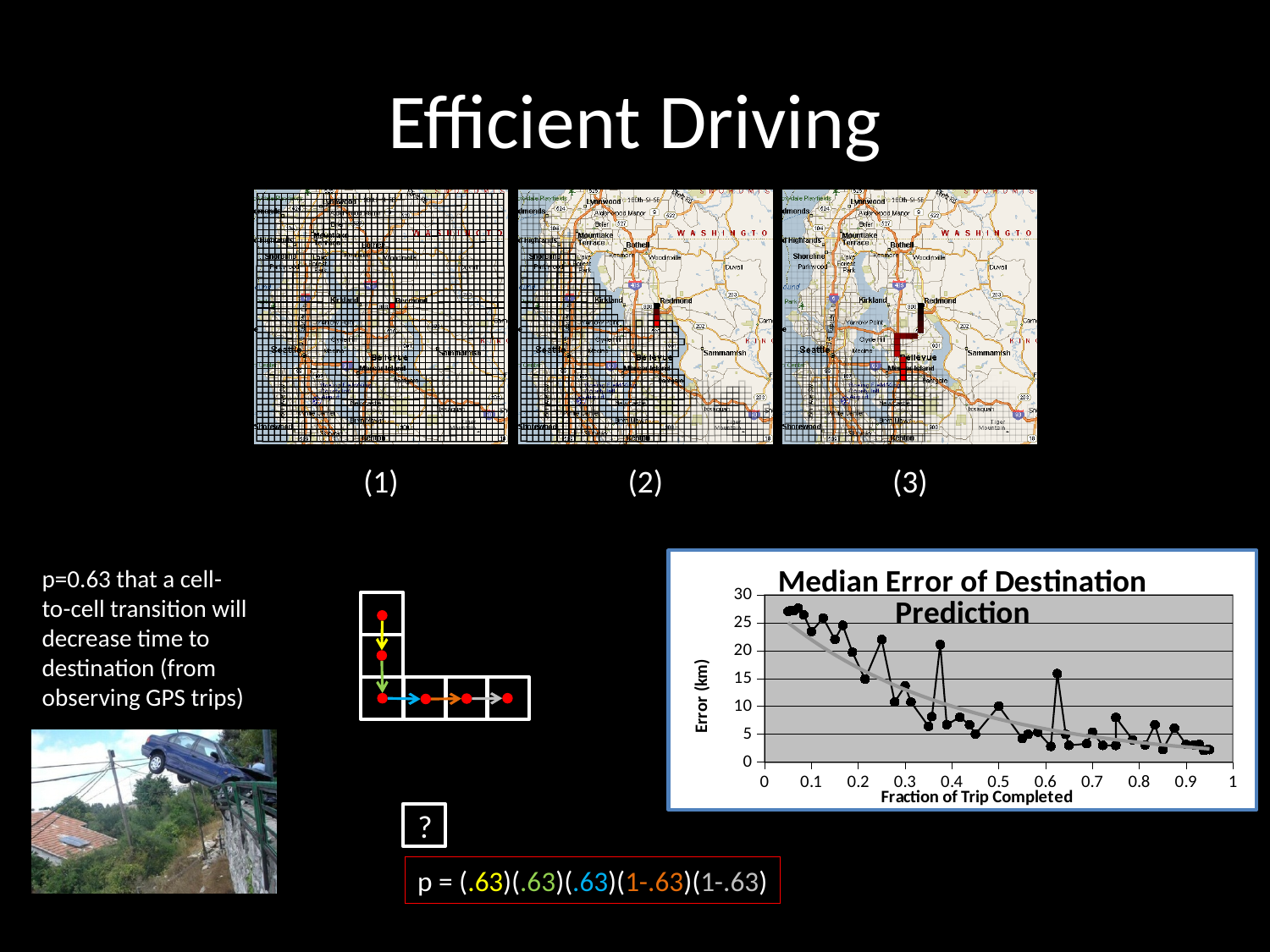
What is the maximum value shown on the y axis of the 'Median Error of Destination Prediction' chart? 30 On the 'Median Error of Destination Prediction' chart, is the error at a fraction of trip completed of about 0.9 greater or less than 10 km? less What is the title of the chart on the slide? Median Error of Destination Prediction On the 'Median Error of Destination Prediction' chart, is the error at a fraction of trip completed of about 0.1 greater or less than 20 km? greater What is the label of the y axis on the 'Median Error of Destination Prediction' chart? Error (km) On the 'Median Error of Destination Prediction' chart, is the error at a fraction of trip completed of about 0.95 greater or less than 5 km? less Do the values on the 'Median Error of Destination Prediction' chart generally rise or fall as the fraction of trip completed increases? fall On the 'Median Error of Destination Prediction' chart, is the error larger near the start of the trip (around 0.1) or near the end of the trip (around 0.9)? near the start (around 0.1) What kind of chart is the 'Median Error of Destination Prediction' chart? line chart